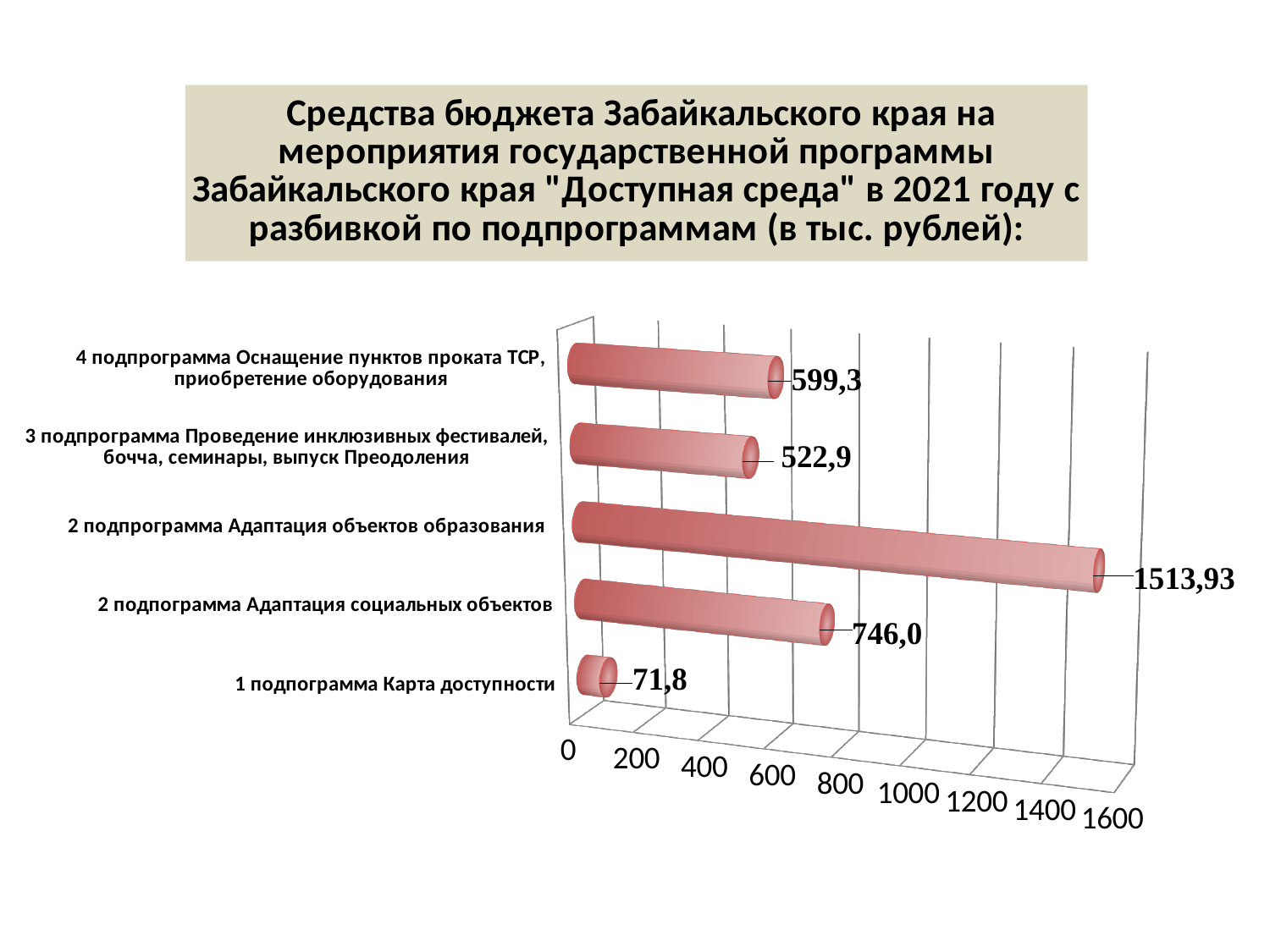
How many subprograms (bars) are shown in the chart? 5 Which subprogram has the highest value? 2 подпрограмма Адаптация объектов образования Which subprogram has the lowest value? 1 подпограмма Карта доступности What is the difference between the values for "2 подпрограмма Адаптация объектов образования" and "2 подпограмма Адаптация социальных объектов"? 767,93 What value is shown for "1 подпограмма Карта доступности"? 71,8 Which is larger: the value for "4 подпрограмма Оснащение пунктов проката ТСР, приобретение оборудования" or for "2 подпограмма Адаптация социальных объектов"? 2 подпограмма Адаптация социальных объектов What is the difference between the values for "4 подпрограмма Оснащение пунктов проката ТСР, приобретение оборудования" and "3 подпрограмма Проведение инклюзивных фестивалей, бочча, семинары, выпуск Преодоления"? 76,4 What value is shown for "2 подпограмма Адаптация социальных объектов"? 746,0 What kind of chart is shown on the slide? Bar chart What value is shown for "3 подпрограмма Проведение инклюзивных фестивалей, бочча, семинары, выпуск Преодоления"? 522,9 What value is shown for "2 подпрограмма Адаптация объектов образования"? 1513,93 Is the value for "2 подпрограмма Адаптация объектов образования" greater or less than 1400? greater